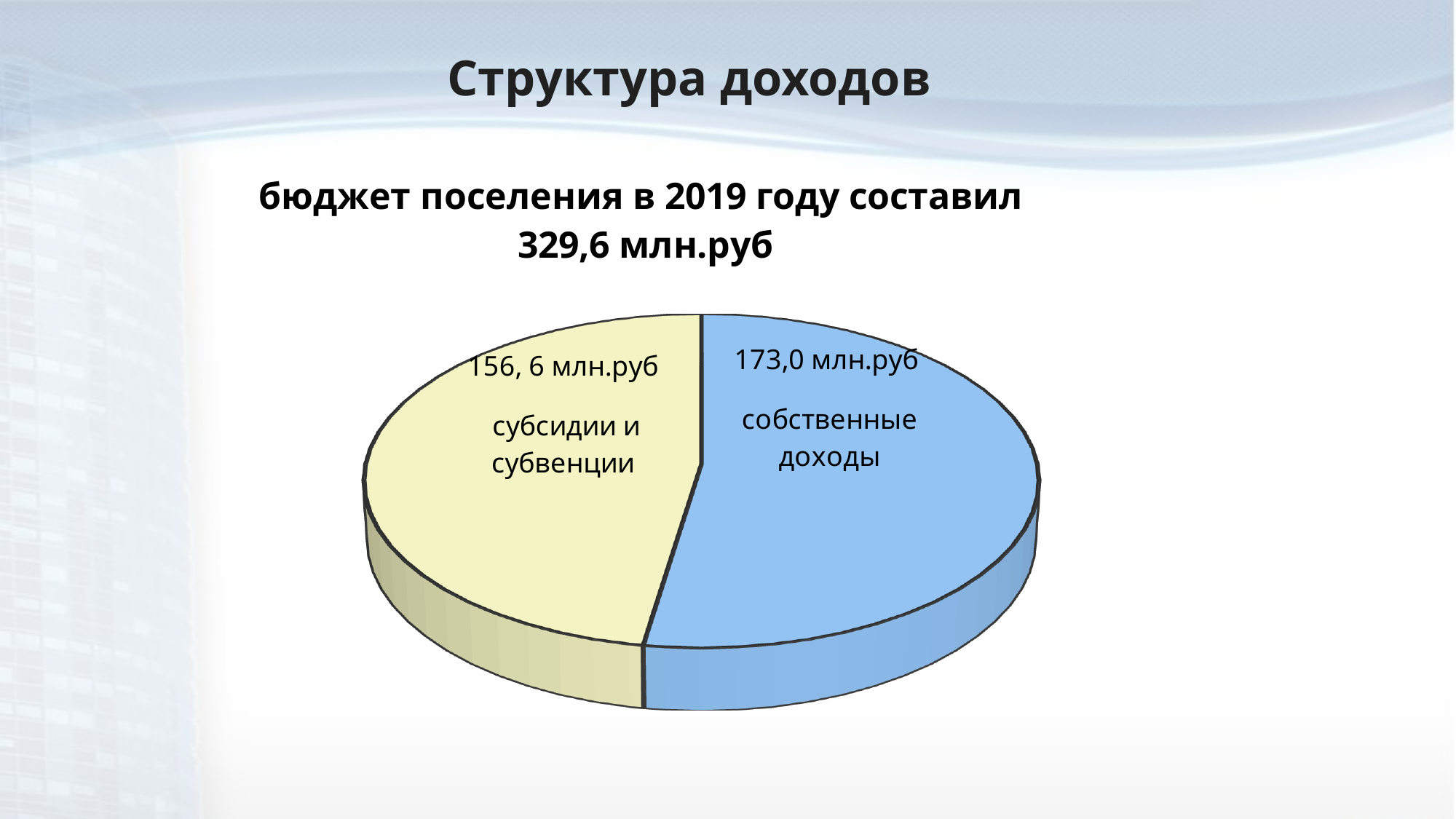
What colour is the 'собственные доходы' slice? blue Which slice of the pie is the smallest? субсидии и субвенции By how much does 'собственные доходы' exceed 'субсидии и субвенции', in млн.руб? 16,4 млн.руб Which slice of the pie is the largest? собственные доходы What is the title of the slide? Структура доходов What is the total of the two slices, as stated on the slide? 329,6 млн.руб Which is larger: 'собственные доходы' or 'субсидии и субвенции'? собственные доходы What is the value of the 'собственные доходы' slice? 173,0 млн.руб What is the value of the 'субсидии и субвенции' slice? 156, 6 млн.руб What kind of chart is shown on the slide? pie chart How many slices does the pie chart have? 2